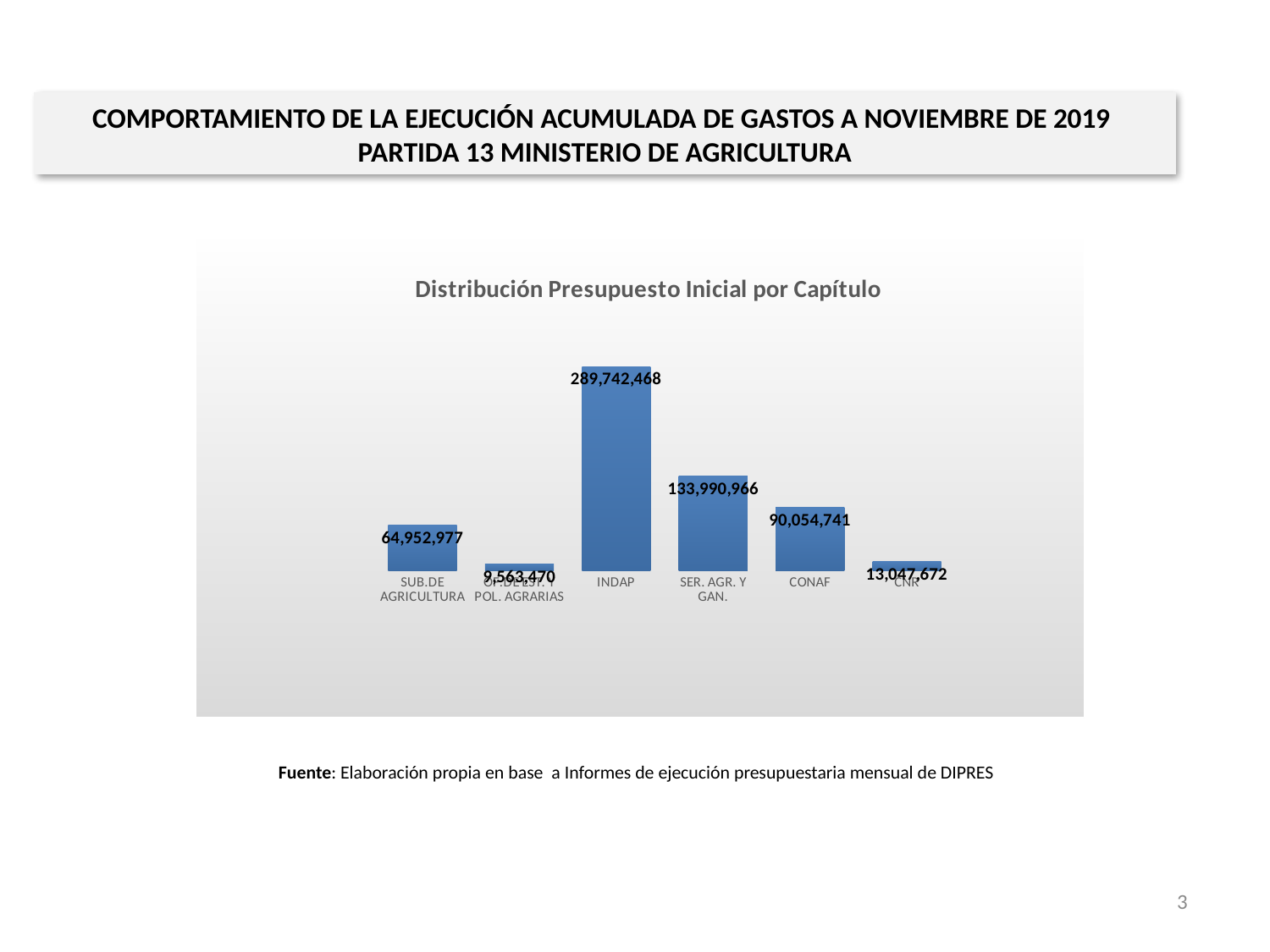
What is the difference between the values for INDAP and SER. AGR. Y GAN.? 155,751,502 Which category has the highest value? INDAP What type of chart is shown on the slide? Bar chart What is the value for INDAP? 289,742,468 What is the value for SER. AGR. Y GAN.? 133,990,966 Which category has the lowest value? OF.DE EST. Y POL. AGRARIAS Which is larger, the value for SER. AGR. Y GAN. or the value for CONAF? SER. AGR. Y GAN. What is the value for CONAF? 90,054,741 What is the difference between the values for CONAF and SUB.DE AGRICULTURA? 25,101,764 What is the value for CNR? 13,047,672 What is the value for SUB.DE AGRICULTURA? 64,952,977 How many categories are shown in the chart? 6